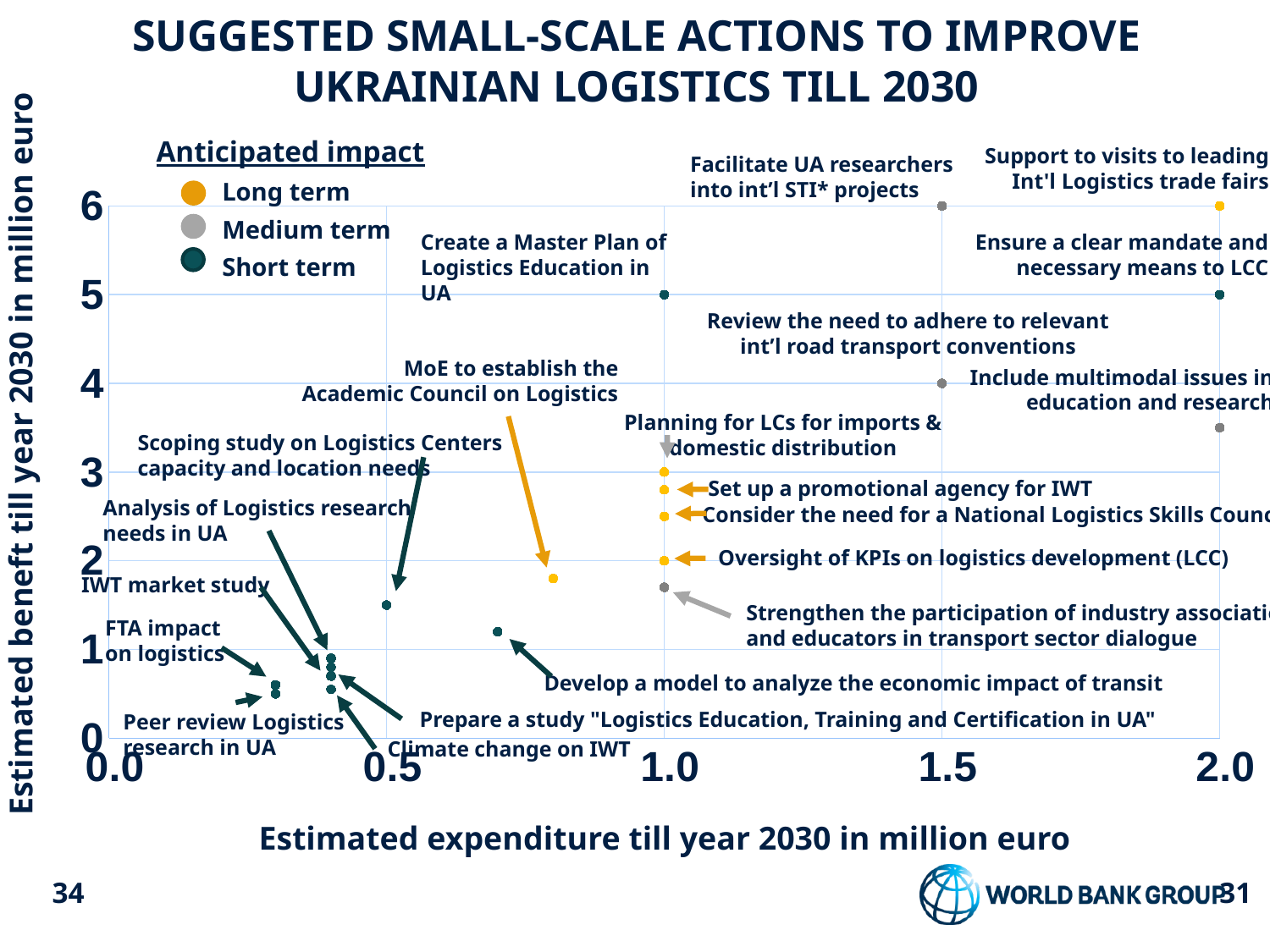
What is the estimated benefit till year 2030 for "Review the need to adhere to relevant int'l road transport conventions"? 4 What kind of chart is shown on the slide? Scatter chart Is the estimated benefit for "Develop a model to analyze the economic impact of transit" greater or less than 1? greater What is the difference in estimated benefit between "Support to visits to leading Int'l Logistics trade fairs" and "Ensure a clear mandate and necessary means to LCC"? 1 How many series does the legend list? 3 Which has the higher estimated benefit: "Oversight of KPIs on logistics development (LCC)" or "Set up a promotional agency for IWT"? Set up a promotional agency for IWT What is the estimated benefit till year 2030 for "Create a Master Plan of Logistics Education in UA"? 5 What is the estimated expenditure till year 2030 for "Ensure a clear mandate and necessary means to LCC"? 2.0 What is the estimated expenditure till year 2030 for "Facilitate UA researchers into int'l STI* projects"? 1.5 Is the estimated benefit for "MoE to establish the Academic Council on Logistics" greater or less than 2? less What is the estimated benefit till year 2030 for "Support to visits to leading Int'l Logistics trade fairs"? 6 What is the title of the x axis? Estimated expenditure till year 2030 in million euro